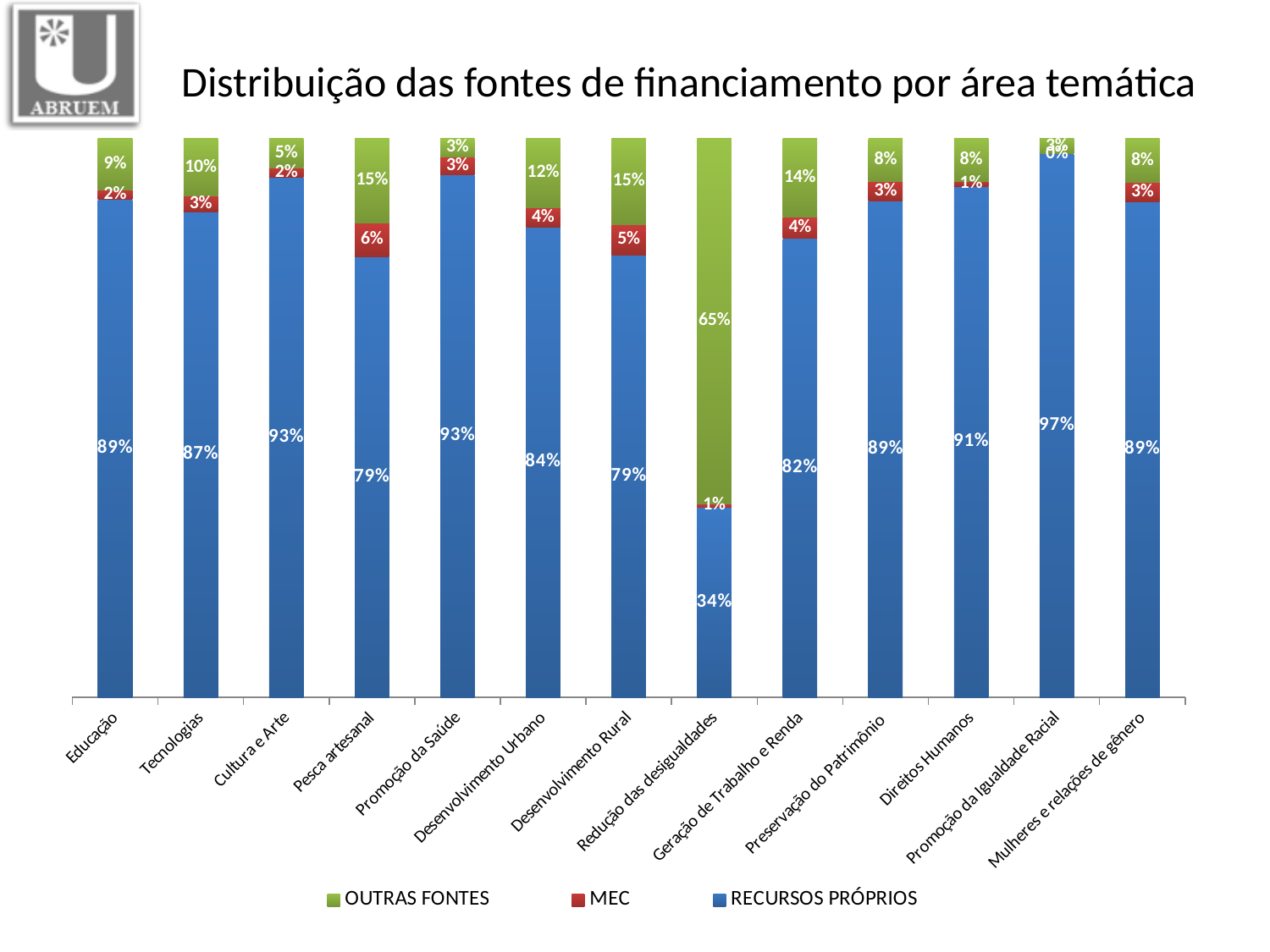
How many series does the legend list? 3 Which category has the highest OUTRAS FONTES value? Redução das desigualdades How many categories are shown on the x axis? 13 What kind of chart is shown on the slide? Stacked bar chart Which category has the highest MEC value? Pesca artesanal Which category has the lowest RECURSOS PRÓPRIOS value? Redução das desigualdades What is the RECURSOS PRÓPRIOS value for Promoção da Igualdade Racial? 97% What is the MEC value for Desenvolvimento Rural? 5% What is the RECURSOS PRÓPRIOS value for Redução das desigualdades? 34% Which is larger, the OUTRAS FONTES value for Desenvolvimento Urbano or for Educação? Desenvolvimento Urbano What is the difference between the RECURSOS PRÓPRIOS values for Cultura e Arte and Tecnologias? 6% What is the OUTRAS FONTES value for Pesca artesanal? 15%